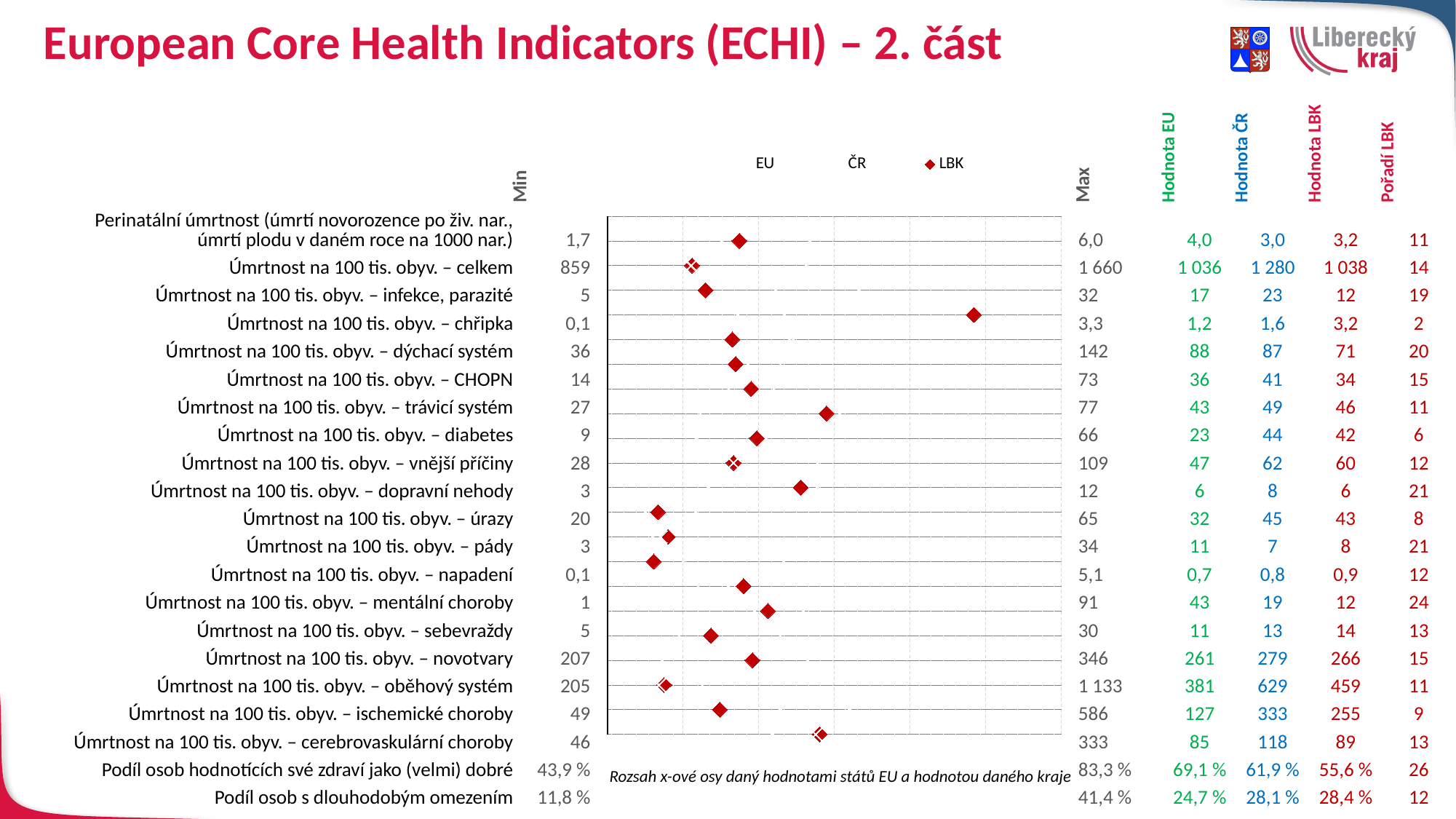
What is the Pořadí LBK value for 'Úmrtnost na 100 tis. obyv. – chřipka'? 2 What is the difference between the Hodnota ČR and Hodnota EU values for 'Úmrtnost na 100 tis. obyv. – oběhový systém'? 248 What is the Max value shown for 'Úmrtnost na 100 tis. obyv. – celkem'? 1 660 How many series does the chart legend list? 3 What are the series names in the chart legend? EU, ČR, LBK What is the Hodnota EU value for 'Úmrtnost na 100 tis. obyv. – celkem'? 1 036 What is the Hodnota ČR value for 'Úmrtnost na 100 tis. obyv. – oběhový systém'? 629 Which indicator has the highest Pořadí LBK value? Podíl osob hodnotících své zdraví jako (velmi) dobré What is the Hodnota LBK value for 'Úmrtnost na 100 tis. obyv. – chřipka'? 3,2 What kind of chart is shown on the slide? scatter chart For 'Úmrtnost na 100 tis. obyv. – diabetes', which is larger: the Hodnota ČR value or the Hodnota LBK value? Hodnota ČR What is the difference between the Hodnota LBK and Hodnota EU values for 'Úmrtnost na 100 tis. obyv. – ischemické choroby'? 128